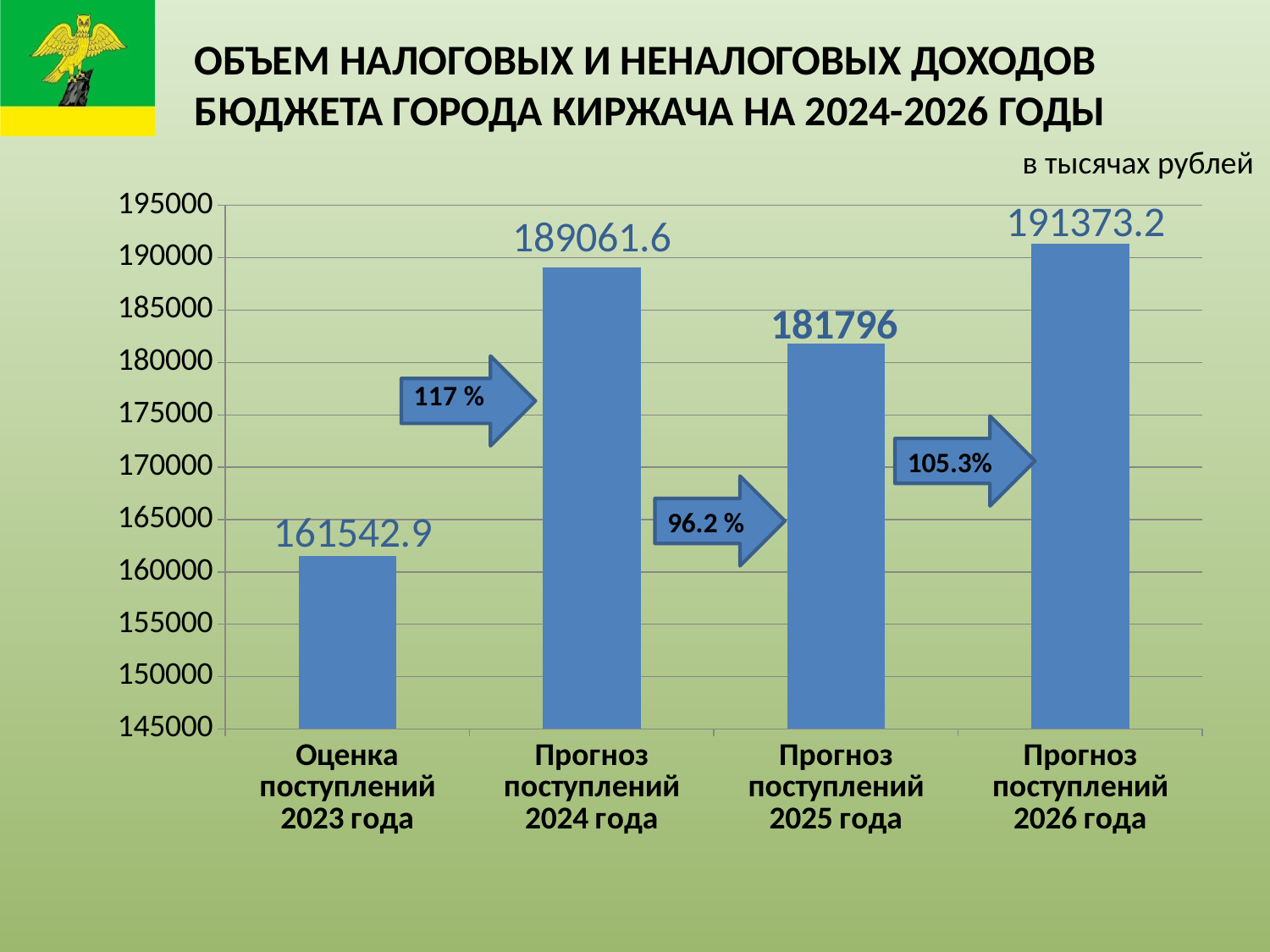
What is the difference between the values for 'Прогноз поступлений 2024 года' and 'Оценка поступлений 2023 года'? 27518.7 How many categories are shown on the chart? 4 Which category has the lowest value? Оценка поступлений 2023 года What is the value for 'Оценка поступлений 2023 года'? 161542.9 Which category has the highest value? Прогноз поступлений 2026 года What is the value for 'Прогноз поступлений 2026 года'? 191373.2 What is the value for 'Прогноз поступлений 2025 года'? 181796 What is the difference between the values for 'Прогноз поступлений 2026 года' and 'Прогноз поступлений 2025 года'? 9577.2 Which is larger: the value for 'Прогноз поступлений 2024 года' or 'Прогноз поступлений 2025 года'? Прогноз поступлений 2024 года What kind of chart is shown on the slide? Bar chart What percentage is shown on the arrow between the 2025 and 2026 bars? 105.3% What is the value for 'Прогноз поступлений 2024 года'? 189061.6